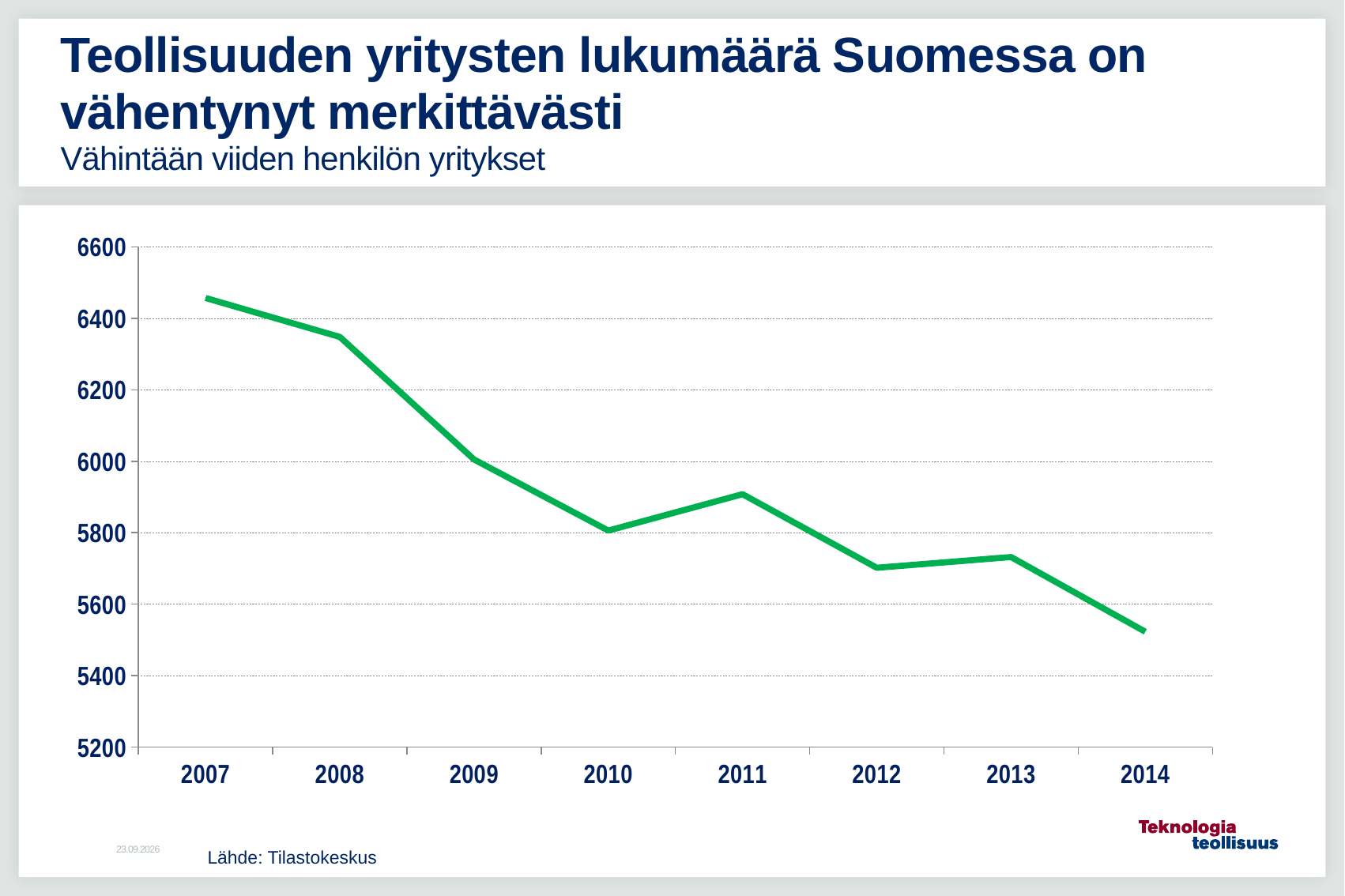
Is the value for 2011 greater or less than 6000? less Is the value for 2007 greater or less than 6400? greater What kind of chart is shown on the slide? line chart Which year has the lowest value? 2014 What source is cited below the chart? Tilastokeskus Is the value for 2012 greater or less than 5800? less Which year has the highest value? 2007 Do the values generally rise or fall from 2007 to 2014? fall How many years are plotted on the x axis? 8 Which is larger, the value for 2010 or the value for 2011? 2011